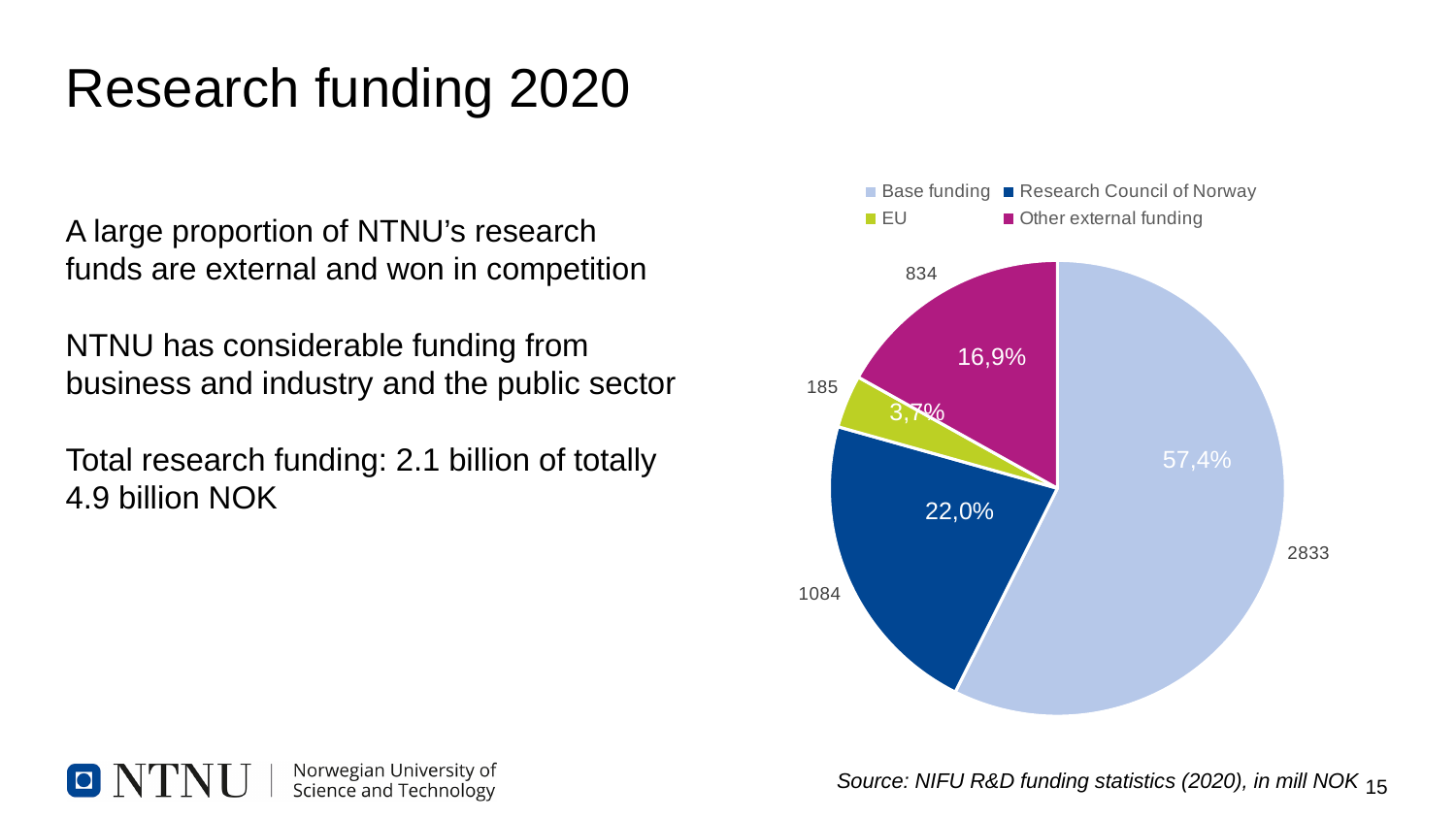
What is the value for Other external funding in the pie chart? 834 What is the value for EU in the pie chart? 185 What is the difference between the values for Research Council of Norway and Other external funding? 250 How many slices does the pie chart have? 4 What share of the pie does Other external funding represent? 16,9% Which category has the largest slice in the pie chart? Base funding What is the value for Base funding in the pie chart? 2833 How many entries does the legend of the pie chart list? 4 What type of chart is shown on the slide? pie chart Which category has the smallest slice in the pie chart? EU What share of the pie does Base funding represent? 57,4% What is the value for Research Council of Norway in the pie chart? 1084